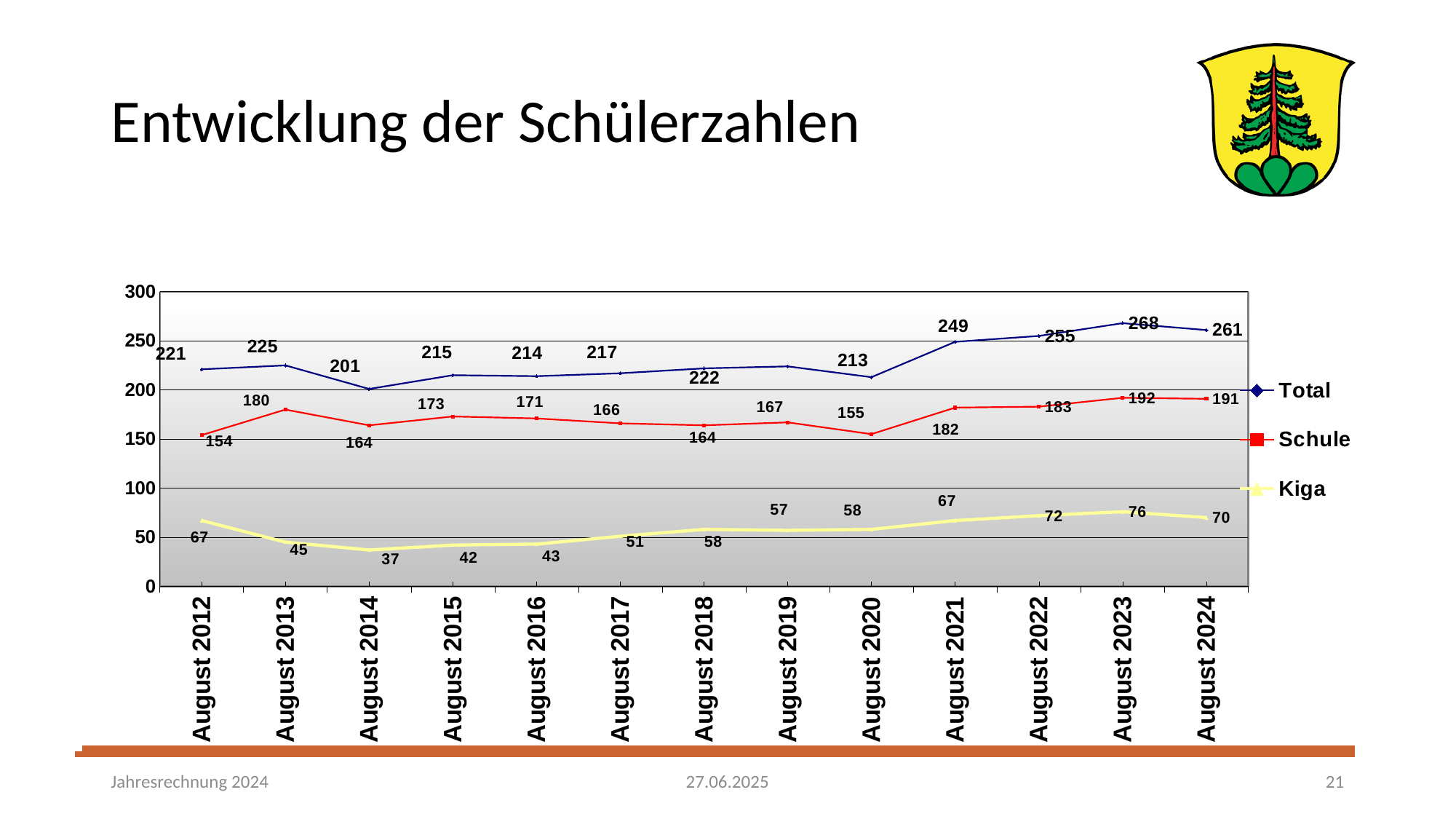
What is the Schule value for August 2020? 155 What is the Total value for August 2023? 268 What is the difference between the Schule values for August 2013 and August 2012? 26 Is the Total value for August 2021 greater or less than 200? greater Which is larger, the Kiga value for August 2012 or for August 2024? August 2024 In which year is the Kiga value lowest? August 2014 What is the title of the chart on the slide? Entwicklung der Schülerzahlen What type of chart is shown on the slide? line chart What is the Kiga value for August 2014? 37 How many time points are plotted along the x axis? 13 How many series does the legend list? 3 In which year does the Total series reach its highest value? August 2023